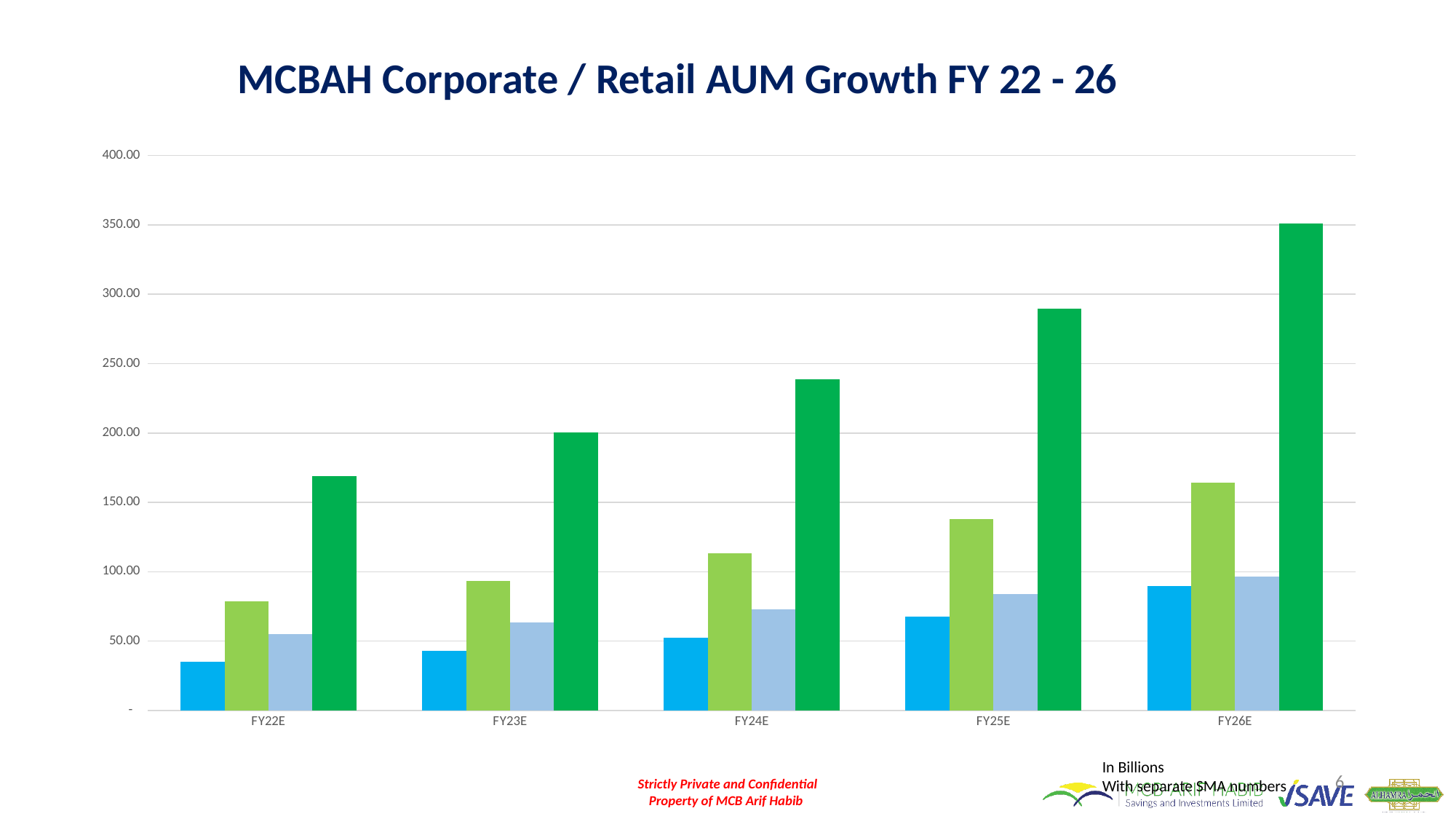
Is the value of the blue bar for FY22E greater or less than 50.00? less Is the value of the dark green bar for FY22E greater or less than 200.00? less Is the value of the dark green bar for FY26E greater or less than 300.00? greater In which fiscal year is the dark green bar the shortest? FY22E What kind of chart is shown on the slide? Bar chart In which fiscal year is the dark green bar the tallest? FY26E How many bars are plotted for each fiscal year? 4 What is the title of the chart? MCBAH Corporate / Retail AUM Growth FY 22 - 26 How many fiscal year categories are shown on the x axis? 5 Do the dark green bars rise or fall from FY22E to FY26E? Rise In FY25E, which is larger: the light green bar or the light blue bar? The light green bar